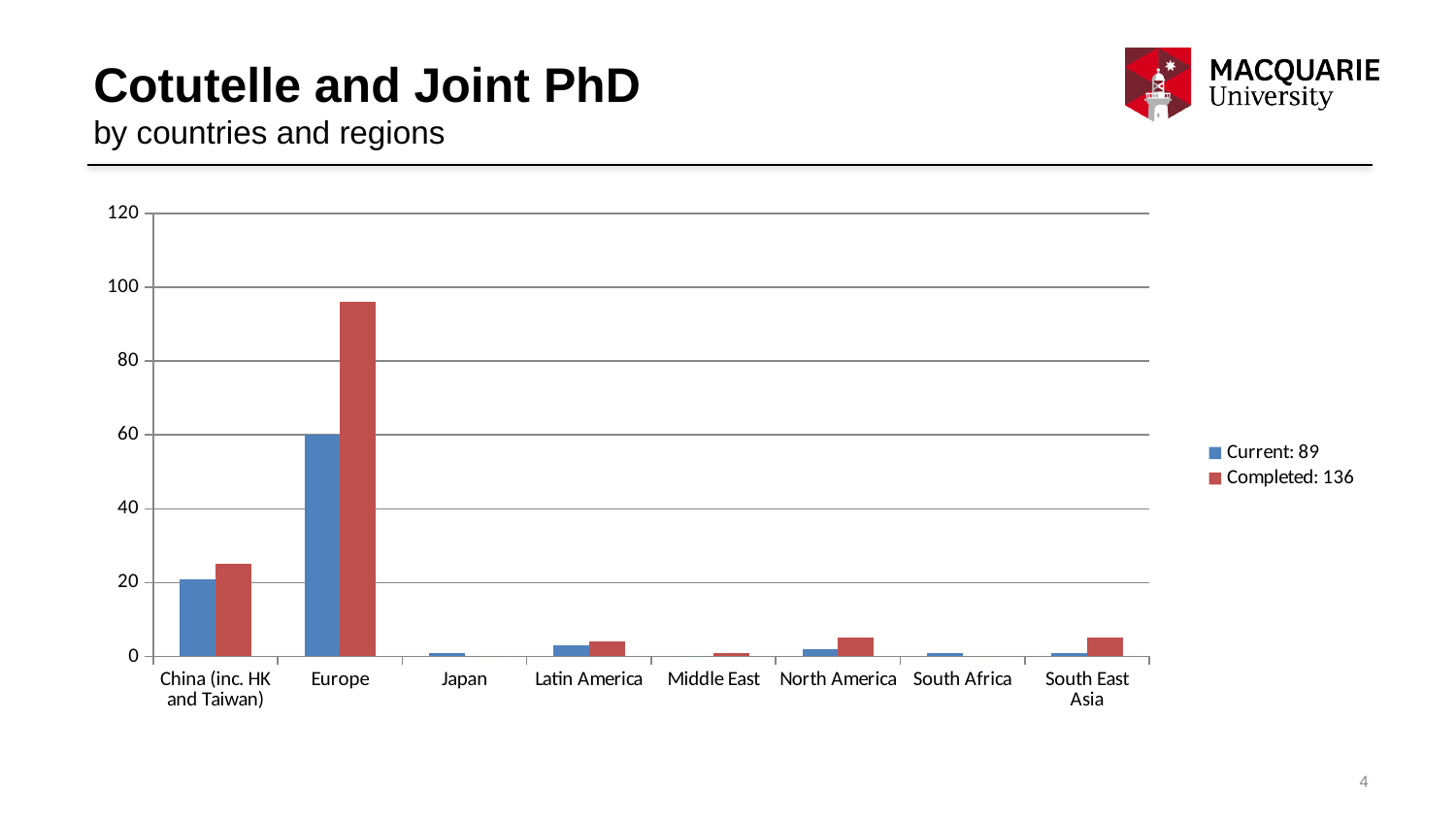
Is the Completed value for Europe greater or less than 80? greater Is the Completed value for China (inc. HK and Taiwan) greater or less than 40? less Which is larger: the Completed value for Europe or the Completed value for China (inc. HK and Taiwan)? Europe What kind of chart is shown on the slide? bar chart How many countries/regions are shown on the x axis? 8 What are the two legend entries of the chart? Current: 89 and Completed: 136 Which country or region has the highest Current value? Europe How many series does the legend list? 2 Which country or region has the highest Completed value? Europe Which is larger: the Current value for China (inc. HK and Taiwan) or the Current value for Latin America? China (inc. HK and Taiwan) Is the Current value for Europe greater or less than 40? greater What is the title of the slide containing the chart? Cotutelle and Joint PhD